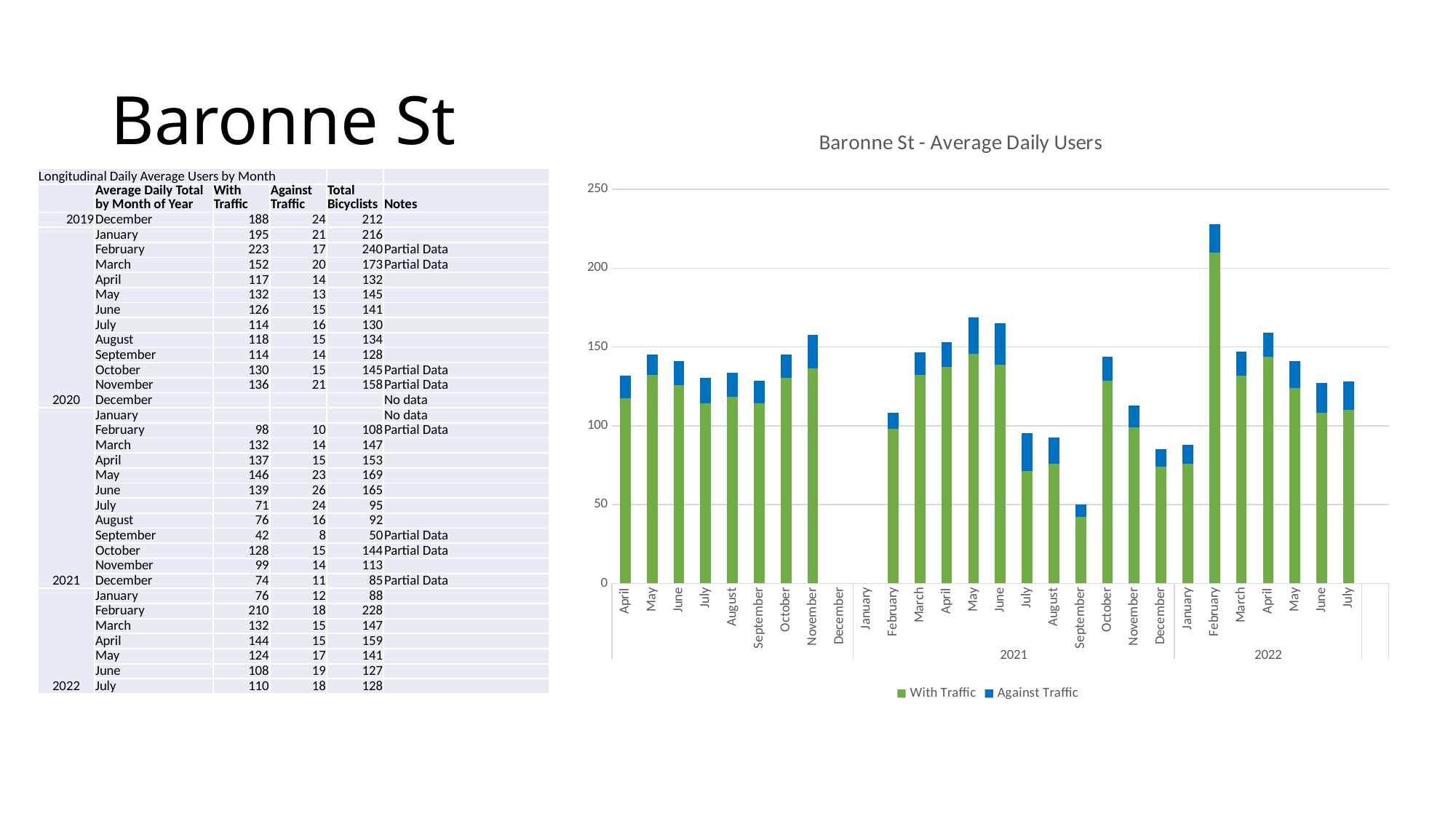
What is the title of the chart? Baronne St - Average Daily Users Is the total bar for September 2021 greater or less than 100? less What kind of chart is shown on the slide? Stacked bar chart Which month has the shortest bar in the chart? September 2021 Do the bar totals rise or fall from April 2022 to July 2022? Fall Which month has the tallest bar in the chart? February 2022 Is the total bar for April 2020 greater or less than 100? greater Which colour represents Against Traffic in the chart? Blue How many series does the chart legend list? 2 Is the total bar for February 2022 greater or less than 200? greater Which bar is taller, February 2022 or November 2020? February 2022